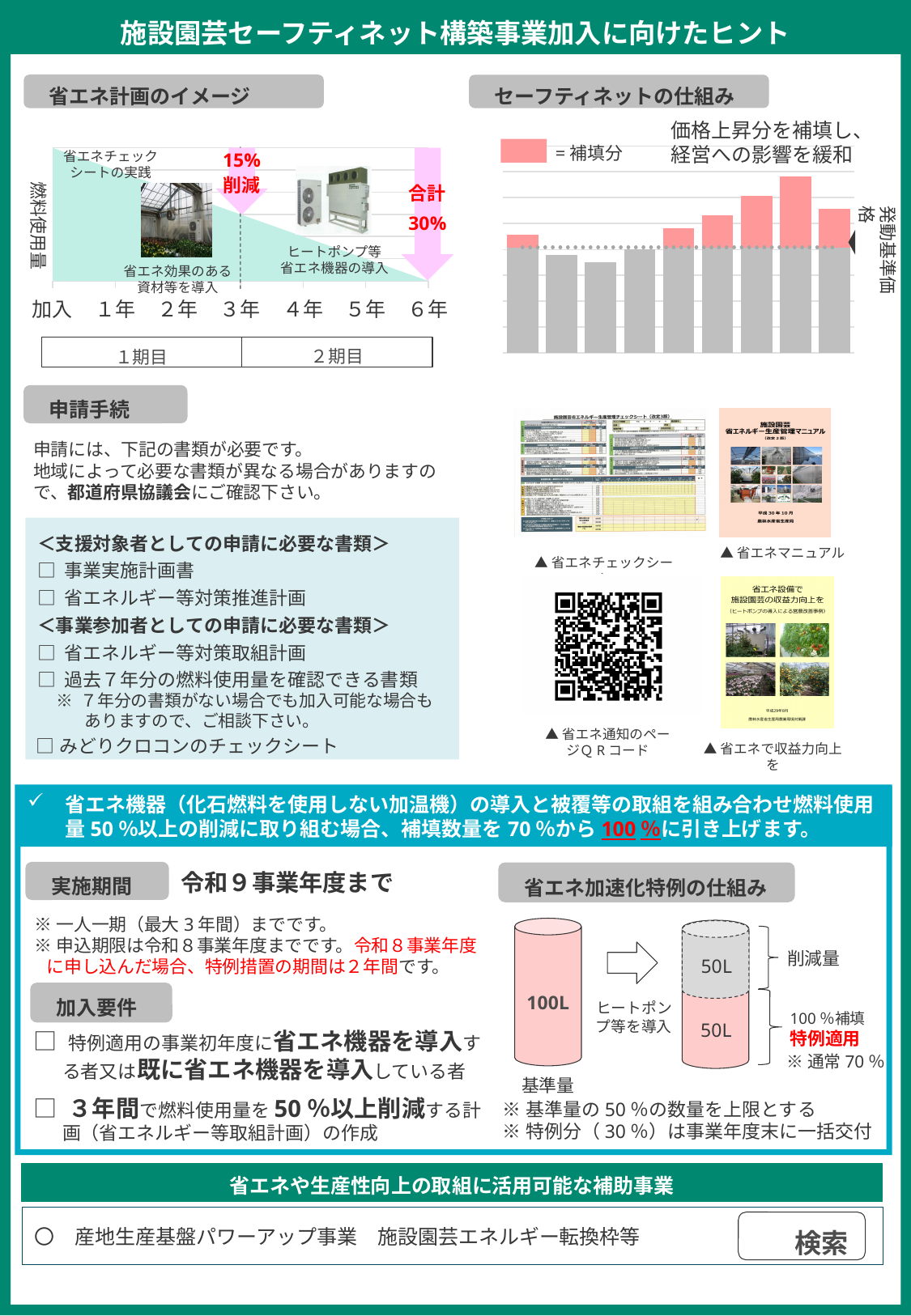
In the セーフティネットの仕組み chart, which bar is the tallest, counting from the left? the 8th bar In the 省エネ計画のイメージ chart, what is the label of the y axis? 燃料使用量 What kind of chart is shown under セーフティネットの仕組み? bar chart In the セーフティネットの仕組み chart, how many bars are plotted? 9 In the 省エネ計画のイメージ chart, does the fuel usage (燃料使用量) rise or fall from 加入 to 6年? fall In the 省エネ計画のイメージ chart, how many points are labelled along the x axis (from 加入 to 6年)? 7 In the 省エネ加速化特例の仕組み diagram, what is the 基準量 shown on the left cylinder? 100L In the セーフティネットの仕組み chart, how many bars have a pink (補填分) portion above the dotted baseline? 6 In the 省エネ計画のイメージ chart, what total reduction is labelled at the 6年 point? 合計30% In the セーフティネットの仕組み chart, what does the pink colour represent according to the legend? 補填分 In the 省エネ計画のイメージ chart, what reduction percentage is labelled at the 3年 point? 15%削減